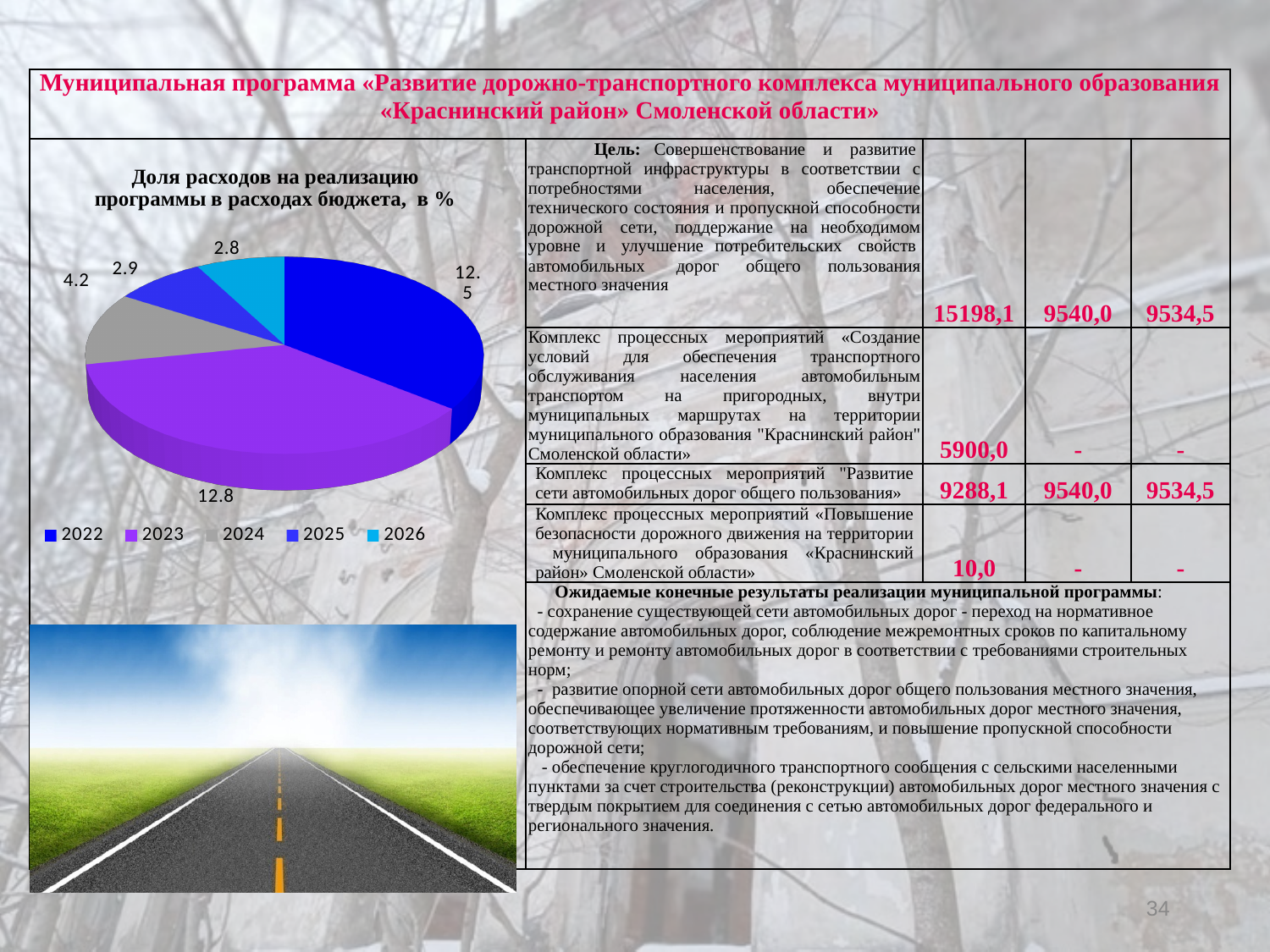
What is the value for 2022 in the pie chart? 12.5 What is the value for 2023 in the pie chart? 12.8 Which year has the smallest slice in the pie chart? 2026 What is the value for 2026 in the pie chart? 2.8 How many series does the legend of the pie chart list? 5 Which year has the largest slice in the pie chart? 2023 What is the title of the pie chart? Доля расходов на реализацию программы в расходах бюджета, в % What is the value for 2024 in the pie chart? 4.2 What is the difference between the values for 2023 and 2022 in the pie chart? 0.3 Which is larger in the pie chart, the value for 2024 or the value for 2025? 2024 What type of chart is shown on the slide? pie chart What is the value for 2025 in the pie chart? 2.9